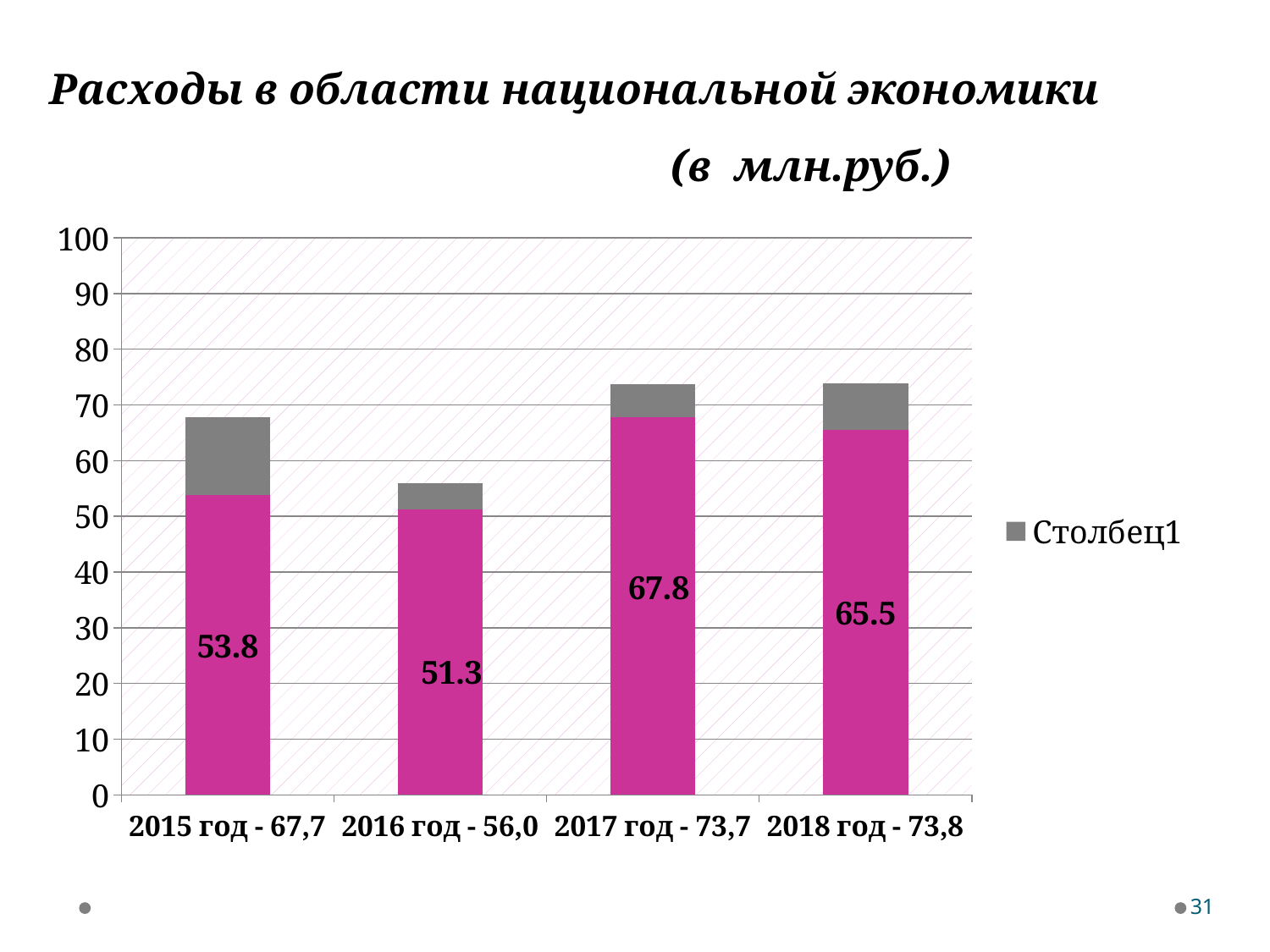
Which category has the lowest labelled magenta value? 2016 год - 56,0 How many categories (years) are shown on the x axis? 4 Which is larger, the magenta value for 2017 or for 2018? 2017 What is the name of the series listed in the legend? Столбец1 What is the value of the magenta segment for the category "2018 год - 73,8"? 65.5 What is the value of the magenta segment for the category "2015 год - 67,7"? 53.8 Which category has the highest labelled magenta value? 2017 год - 73,7 Is the total height of the stacked bar for 2016 greater or less than 60? less What kind of chart is shown on the slide? bar chart What is the difference between the magenta values for 2017 (67.8) and 2016 (51.3)? 16.5 How many series does the legend list? 1 What is the value of the magenta segment for the category "2017 год - 73,7"? 67.8